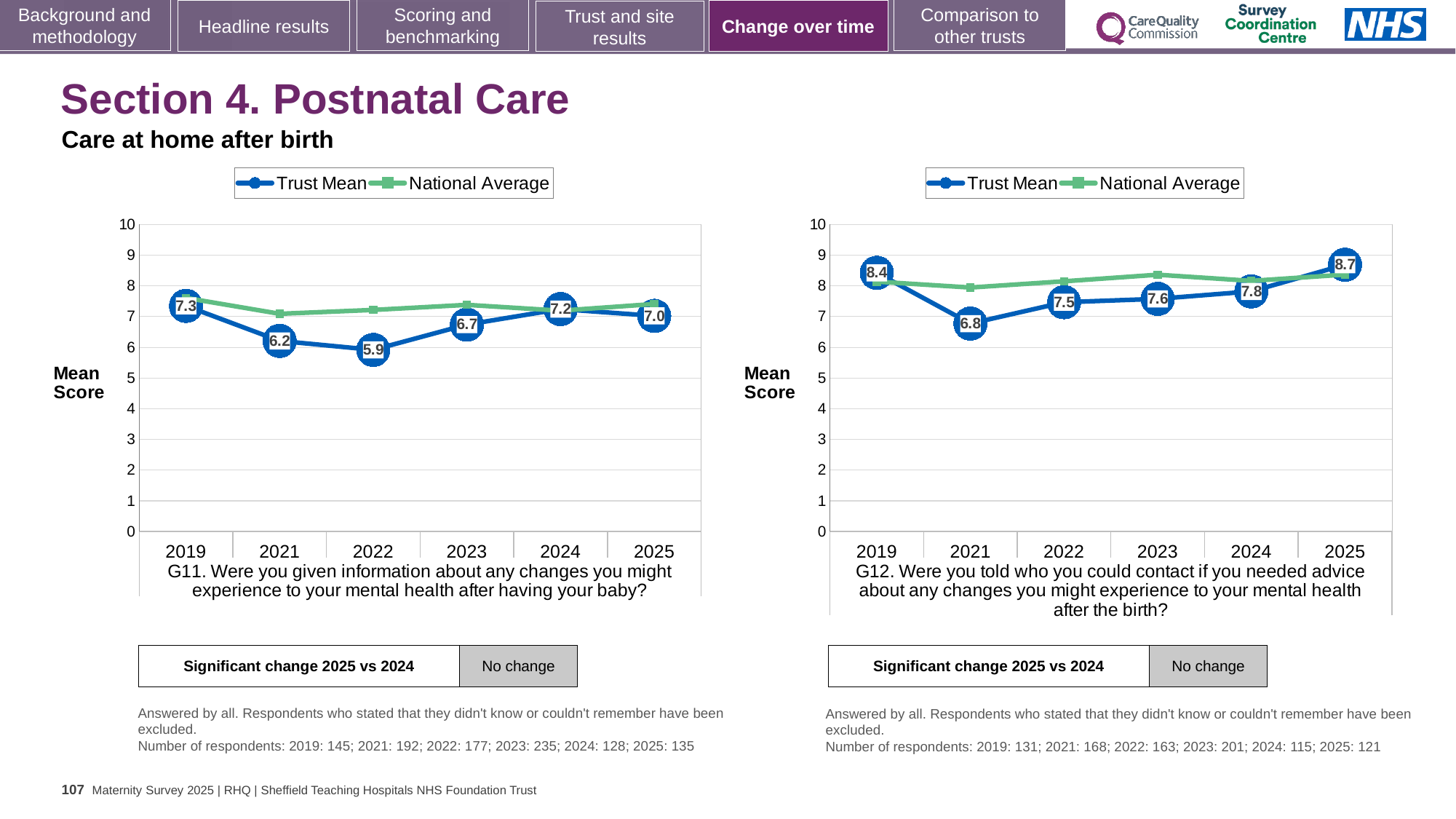
In the G12 chart (right), does the Trust Mean rise or fall from 2021 to 2025? Rise In the G12 chart (right), which year has the highest Trust Mean? 2025 In the G11 chart (left), which year has the lowest Trust Mean? 2022 In the G12 chart (right), what is the Trust Mean for 2025? 8.7 What does the 'Significant change 2025 vs 2024' box below the G11 chart (left) say? No change In the G11 chart (left), what is the Trust Mean for 2022? 5.9 What type of chart is the G11 chart (left)? Line chart How many years are plotted on the x axis of the G11 chart (left)? 6 In the G12 chart (right), what is the difference between the Trust Mean in 2025 and in 2021? 1.9 How many series does the legend of the G12 chart (right) list? 2 In the G11 chart (left), is the Trust Mean higher in 2019 or in 2025? 2019 In the G12 chart (right), is the National Average for 2021 greater or less than 7? greater